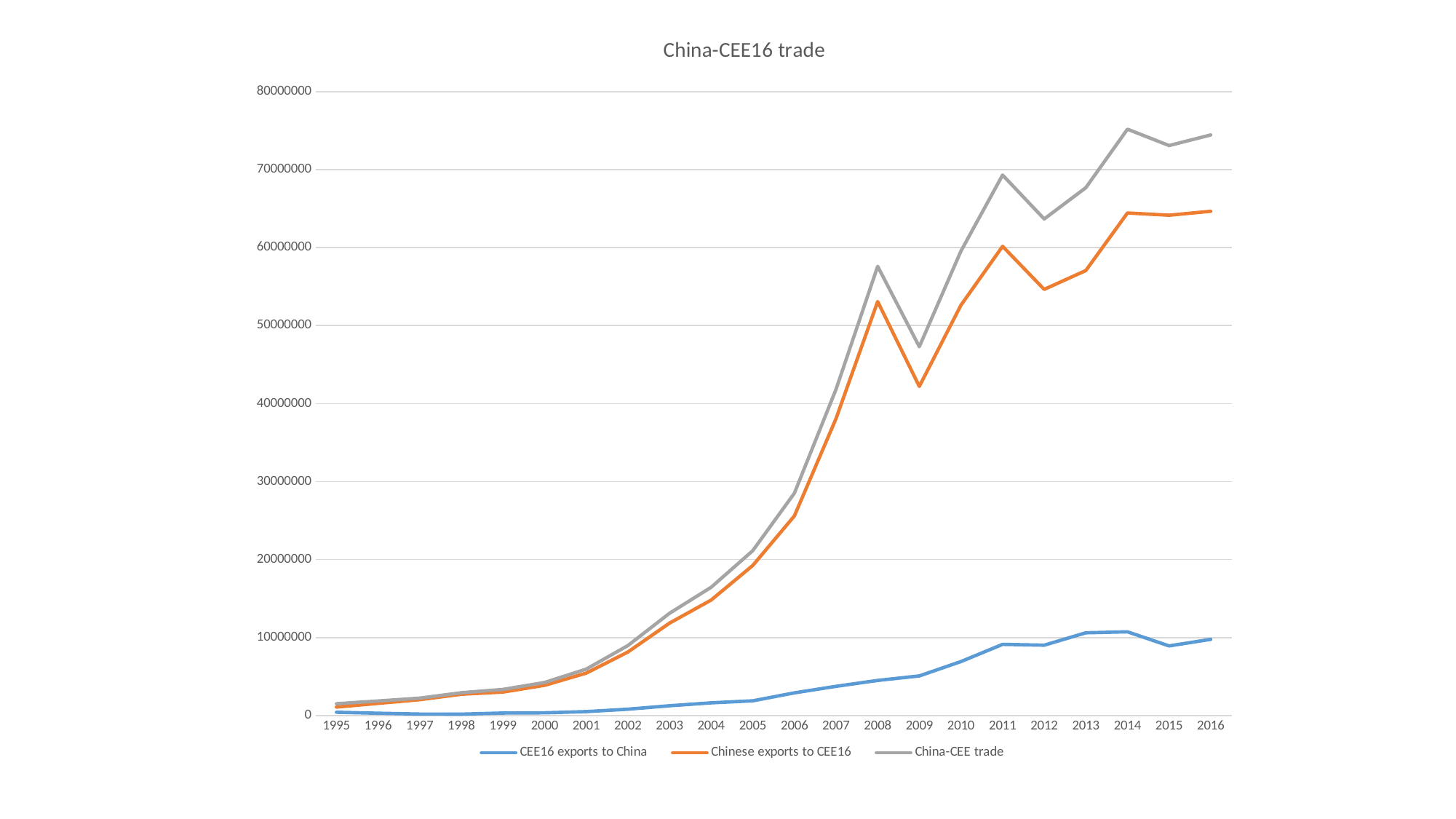
Which year has the larger value for China-CEE trade, 2008 or 2009? 2008 Which year has the larger value for Chinese exports to CEE16, 2011 or 2012? 2011 What kind of chart is shown on the slide? line chart Is the value for Chinese exports to CEE16 in 2006 greater or less than 30000000? less What is the title of the chart? China-CEE16 trade Does the CEE16 exports to China series rise or fall from 1995 to 2011? rise Is the value for China-CEE trade in 2008 greater or less than 50000000? greater How many years are plotted along the x axis? 22 In which year is the China-CEE trade series at its lowest? 1995 In which year does the China-CEE trade series reach its highest value? 2014 Is the value for Chinese exports to CEE16 in 2009 greater or less than 50000000? less How many series does the legend list? 3